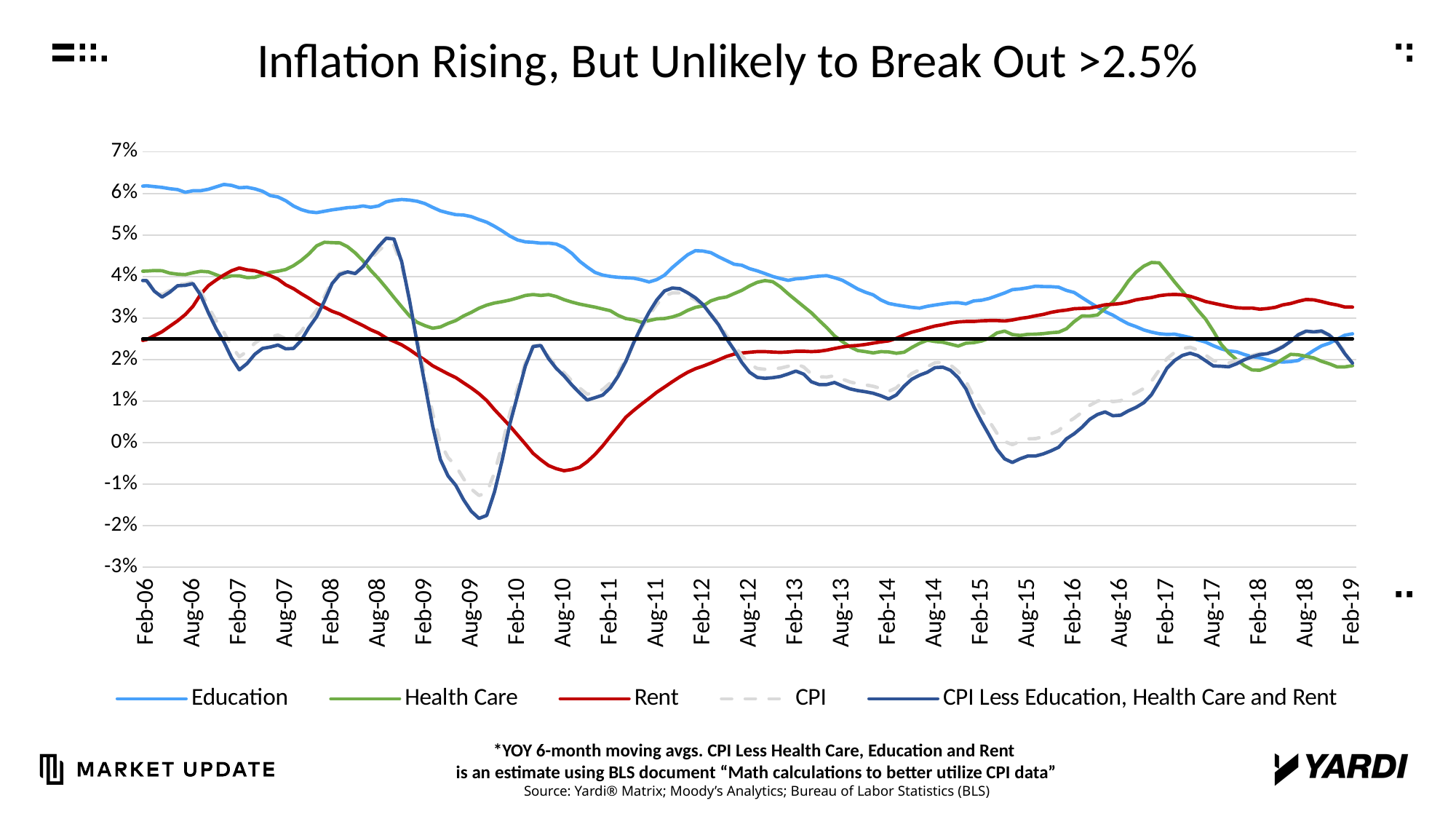
At Aug-15, which is higher, Rent or CPI? Rent Which series has the lowest value at Aug-09? CPI Less Education, Health Care and Rent At what level is the horizontal black reference line drawn across the chart? 2.5% Is the value for CPI Less Education, Health Care and Rent at Aug-09 greater or less than -1%? less Is the value for Health Care at Feb-17 greater or less than 4%? greater Which series has the highest value at Feb-06? Education Is the value for Rent at Aug-10 greater or less than 0%? less What is the title of the chart? Inflation Rising, But Unlikely to Break Out >2.5% Does the Education series rise or fall overall from Feb-06 to Feb-19? fall How many series does the legend list? 5 What kind of chart is shown on the slide? line chart